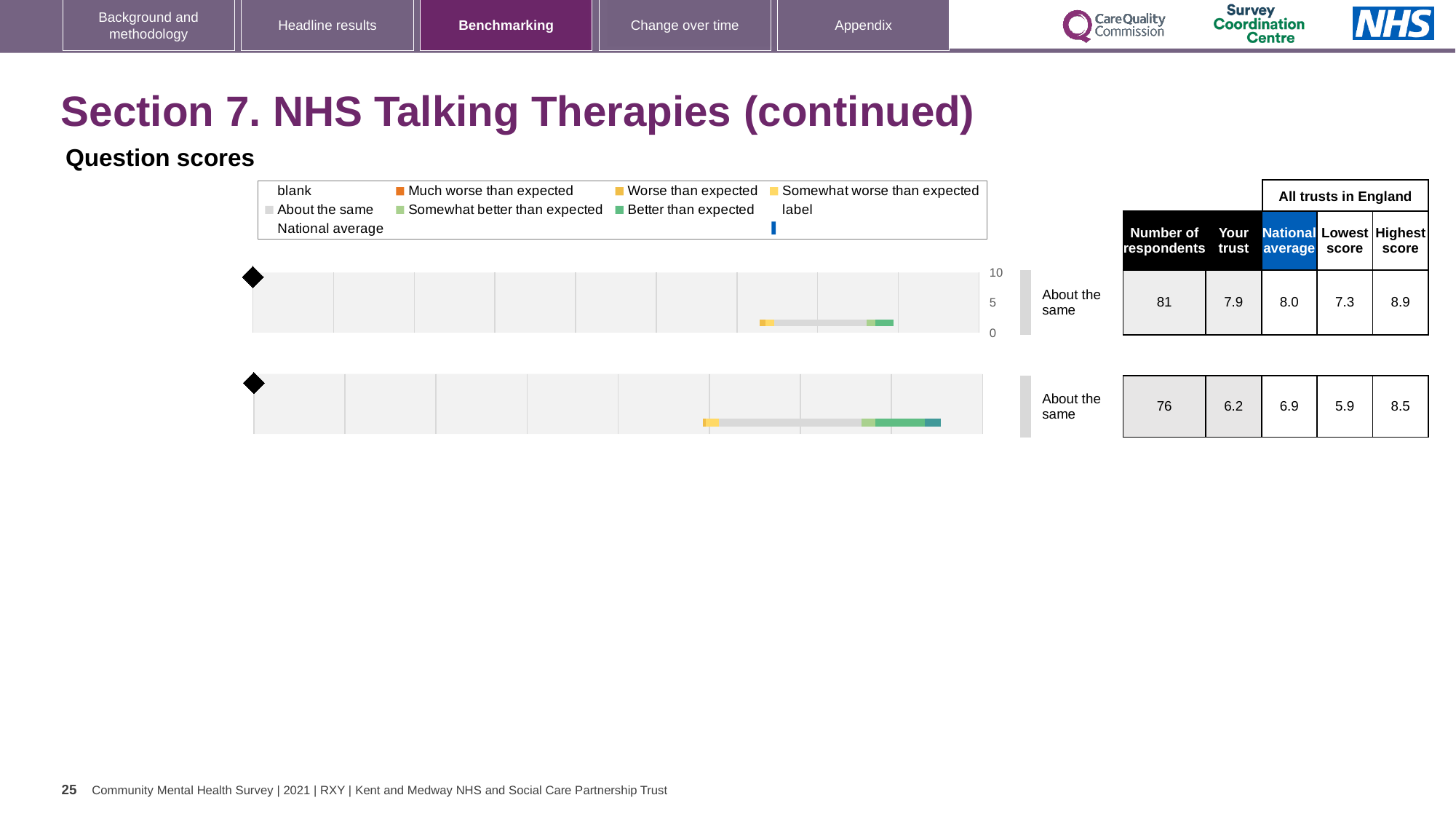
For the bottom chart, what is the 'Your trust' score? 6.2 For the bottom chart, what is the difference between the national average and the 'Your trust' score? 0.7 Which chart has the higher 'Your trust' score, the top chart or the bottom chart? top chart For the top chart, what is the national average score? 8.0 How many question score charts are shown on the slide? 2 For the bottom chart, what is the lowest score among all trusts in England? 5.9 For the top chart, how many respondents are there? 81 What kind of chart is used to show the question scores on this slide? bar chart For the bottom chart, what is the national average score? 6.9 For the top chart, what is the difference between the highest score and the lowest score among all trusts in England? 1.6 For the top chart, what is the 'Your trust' score shown in the table? 7.9 What is the maximum value shown on the score axis of the charts? 10